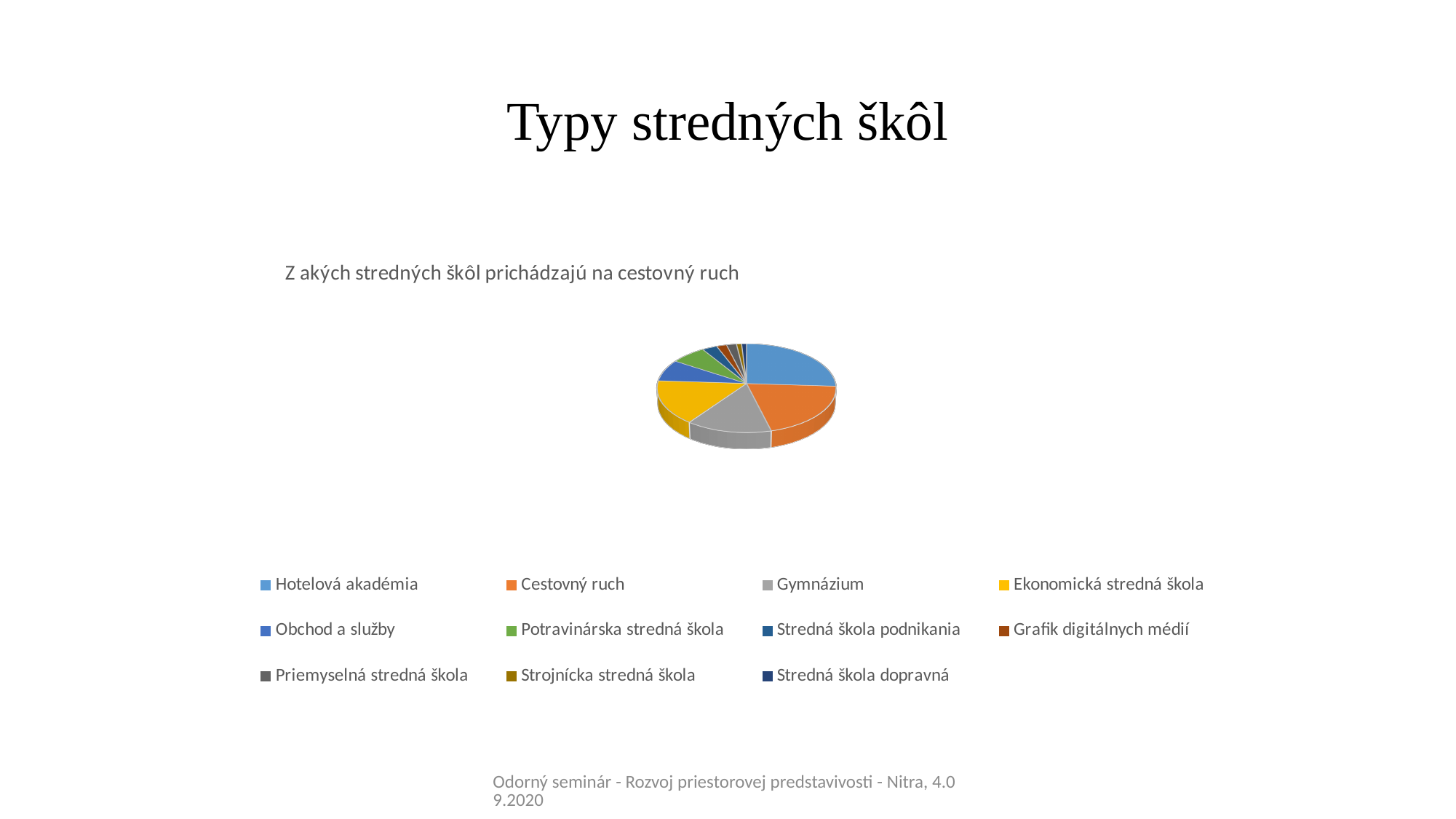
How many categories does the pie chart's legend list? 11 Which slice is larger, Ekonomická stredná škola or Grafik digitálnych médií? Ekonomická stredná škola Which slice is larger, Hotelová akadémia or Obchod a služby? Hotelová akadémia What kind of chart is shown on the slide? pie chart Which slice is larger, Gymnázium or Stredná škola podnikania? Gymnázium How many data series does the pie chart show? 1 What is the title of the chart? Z akých stredných škôl prichádzajú na cestovný ruch Which category is shown in orange in the legend? Cestovný ruch